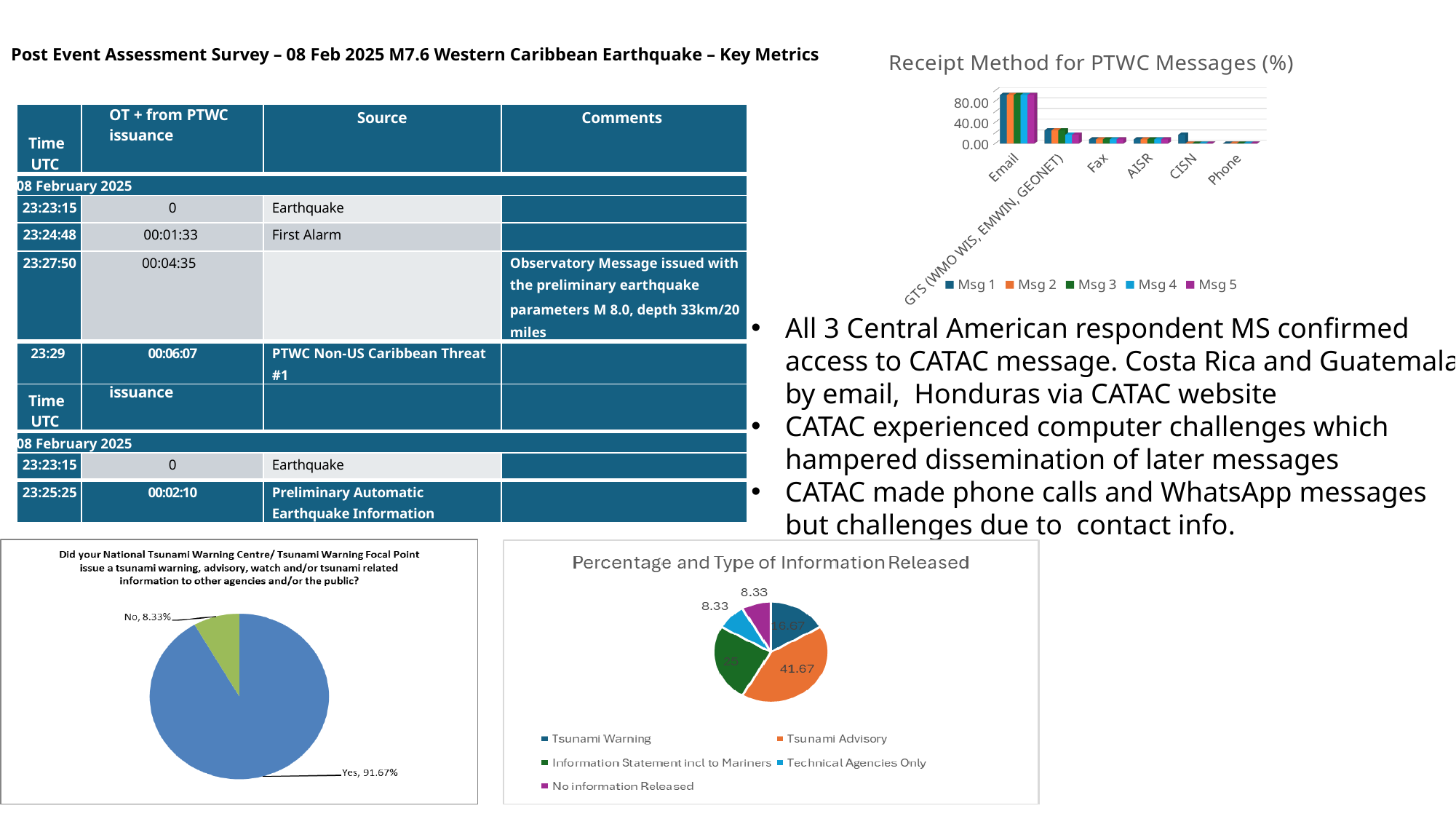
In the 'Receipt Method for PTWC Messages (%)' chart, is the Msg 1 value for Fax greater or less than 40.00? less In the 'Receipt Method for PTWC Messages (%)' chart, how many series does the legend list? 5 In the 'Receipt Method for PTWC Messages (%)' chart, which receipt method has the highest values? Email In the 'Receipt Method for PTWC Messages (%)' chart, how many receipt method categories are shown on the x axis? 6 In the 'Receipt Method for PTWC Messages (%)' chart, is the Msg 1 value for Email greater or less than 80.00? greater In the 'Percentage and Type of Information Released' pie chart, what is the difference between the Tsunami Advisory and Tsunami Warning values? 25 In the 'Receipt Method for PTWC Messages (%)' chart, what kind of chart is shown? bar chart In the pie chart about whether the National Tsunami Warning Centre issued a warning, what share answered No? 8.33% In the 'Percentage and Type of Information Released' pie chart, what is the value for Tsunami Advisory? 41.67 In the pie chart about whether the National Tsunami Warning Centre issued a warning, what share answered Yes? 91.67% In the 'Percentage and Type of Information Released' pie chart, how many categories does the legend list? 5 In the 'Percentage and Type of Information Released' pie chart, which type of information has the largest share? Tsunami Advisory